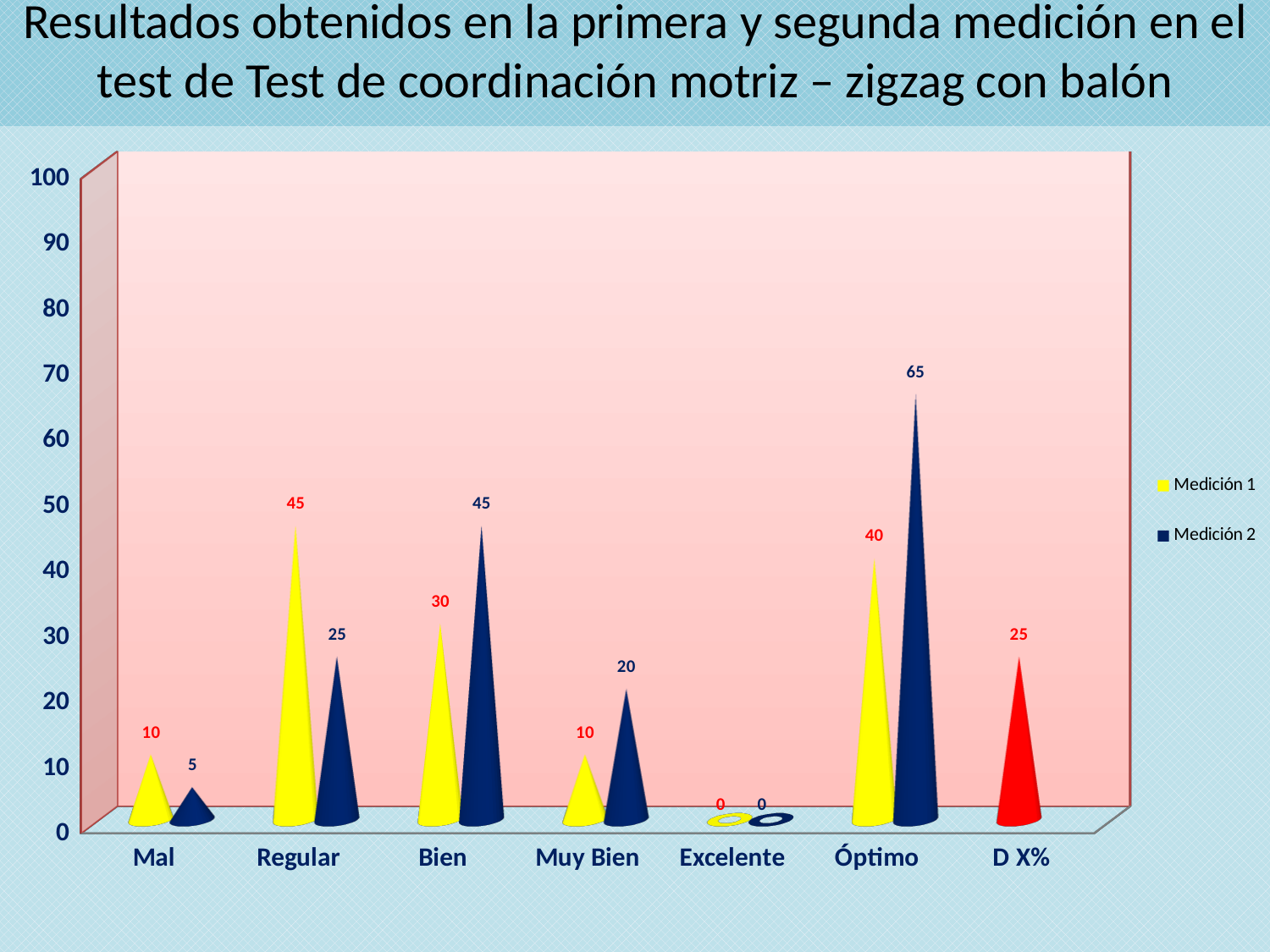
What kind of chart is shown on the slide? Bar chart Which category has the highest value for Medición 2? Óptimo In the Bien category, which is larger: Medición 1 or Medición 2? Medición 2 How many series does the legend list? 2 What is the value for Medición 2 in the Muy Bien category? 20 How many categories are shown on the x axis? 7 What is the difference between Medición 2 and Medición 1 in the Óptimo category? 25 What is the value for Medición 2 in the Óptimo category? 65 What is the value for Medición 1 in the Bien category? 30 What is the value for Medición 1 in the Regular category? 45 Which category has the lowest value for Medición 1? Excelente What colour represents Medición 1 in the legend? Yellow